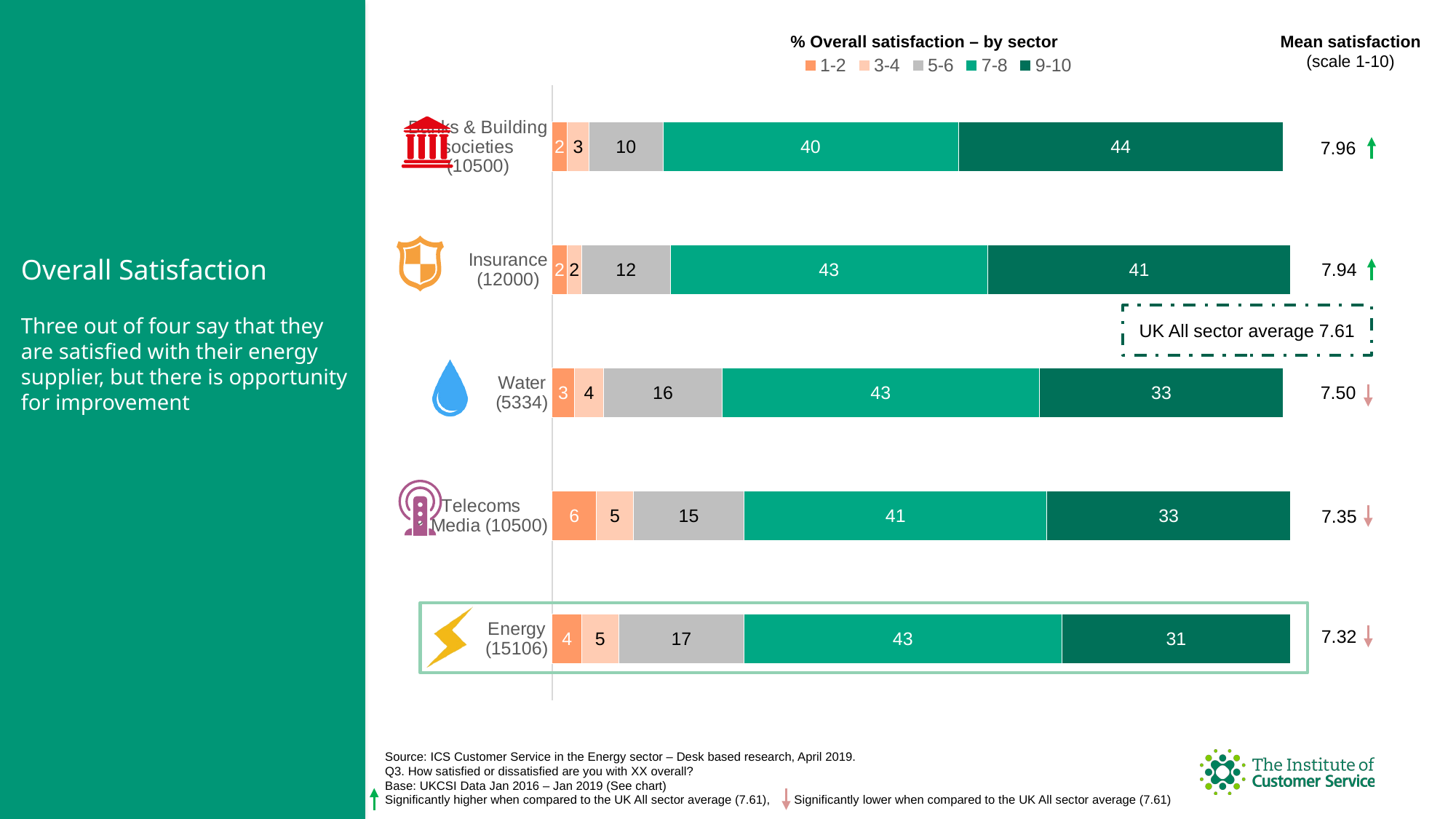
What is the mean satisfaction score for Telecoms & Media? 7.35 What percentage of Water respondents gave a 5-6 satisfaction score? 16 What percentage of Energy respondents gave a 9-10 satisfaction score? 31 What is the UK All sector average mean satisfaction shown on the chart? 7.61 What is the difference between the 9-10 share for Banks & Building Societies and the 9-10 share for Energy? 13 What kind of chart is shown on the slide? Stacked bar chart Which sector has a larger 1-2 share, Telecoms & Media or Water? Telecoms & Media Which sector has the highest share of 9-10 satisfaction scores? Banks & Building Societies Which sector has the lowest mean satisfaction score? Energy How many series does the legend of the '% Overall satisfaction – by sector' chart list? 5 What is the total of the stacked bar for Energy? 100 How many sectors are plotted in the '% Overall satisfaction – by sector' chart? 5